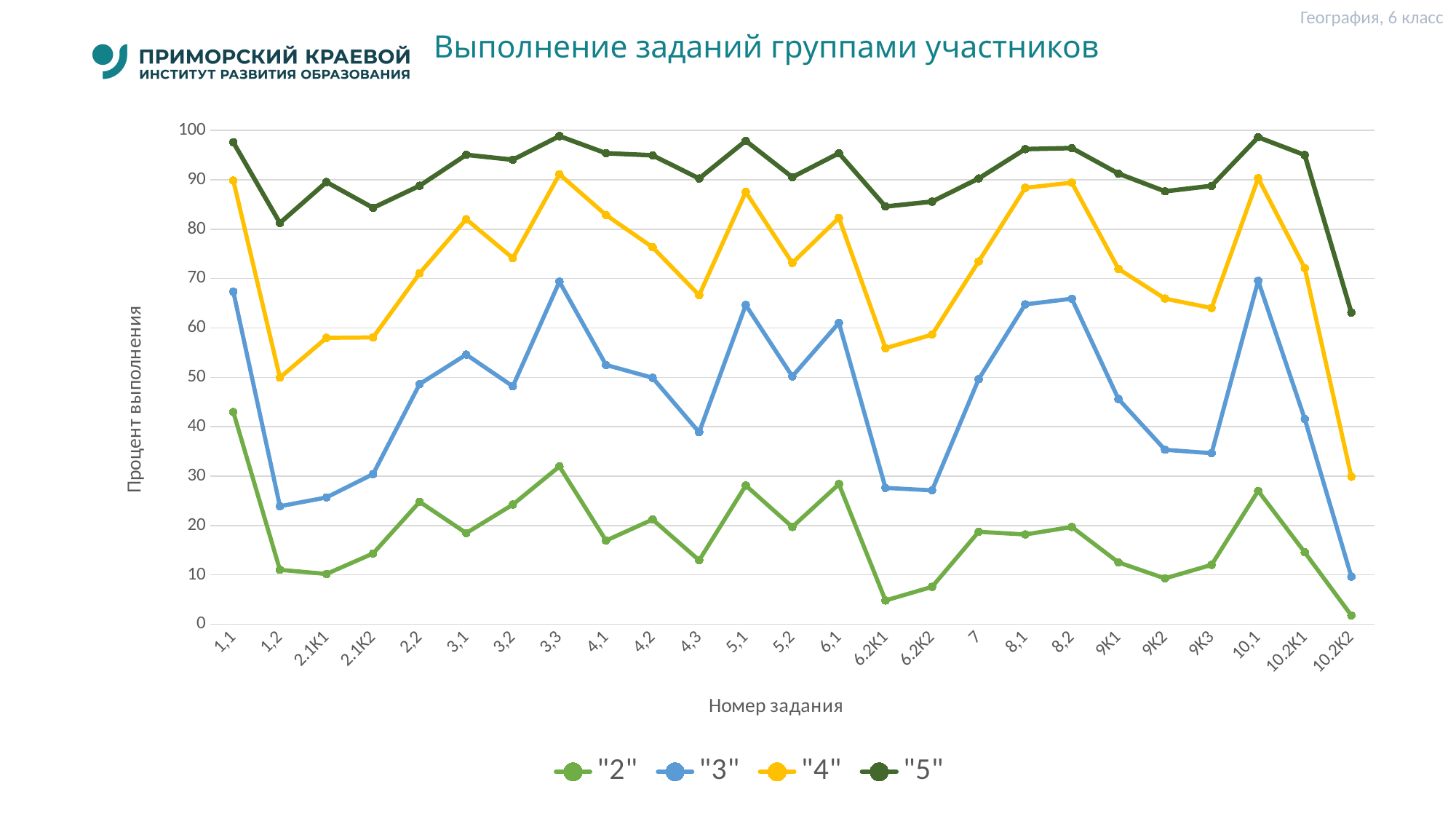
Is the value for series "3" at task 3,3 greater or less than 60? greater How many task numbers are shown along the x axis? 25 How many series does the legend list? 4 Do the values for series "4" rise or fall from task 10,1 to task 10.2K2? fall Is the value for series "4" at task 1,2 greater or less than 60? less What is the title of the vertical axis? Процент выполнения For series "5", which task has the lowest value? 10.2K2 At task 6.2K1, which series has the larger value, "3" or "4"? "4" Is the value for series "2" at task 10.2K2 greater or less than 10? less For series "2", which task has the highest value? 1,1 What kind of chart is shown on the slide? line chart